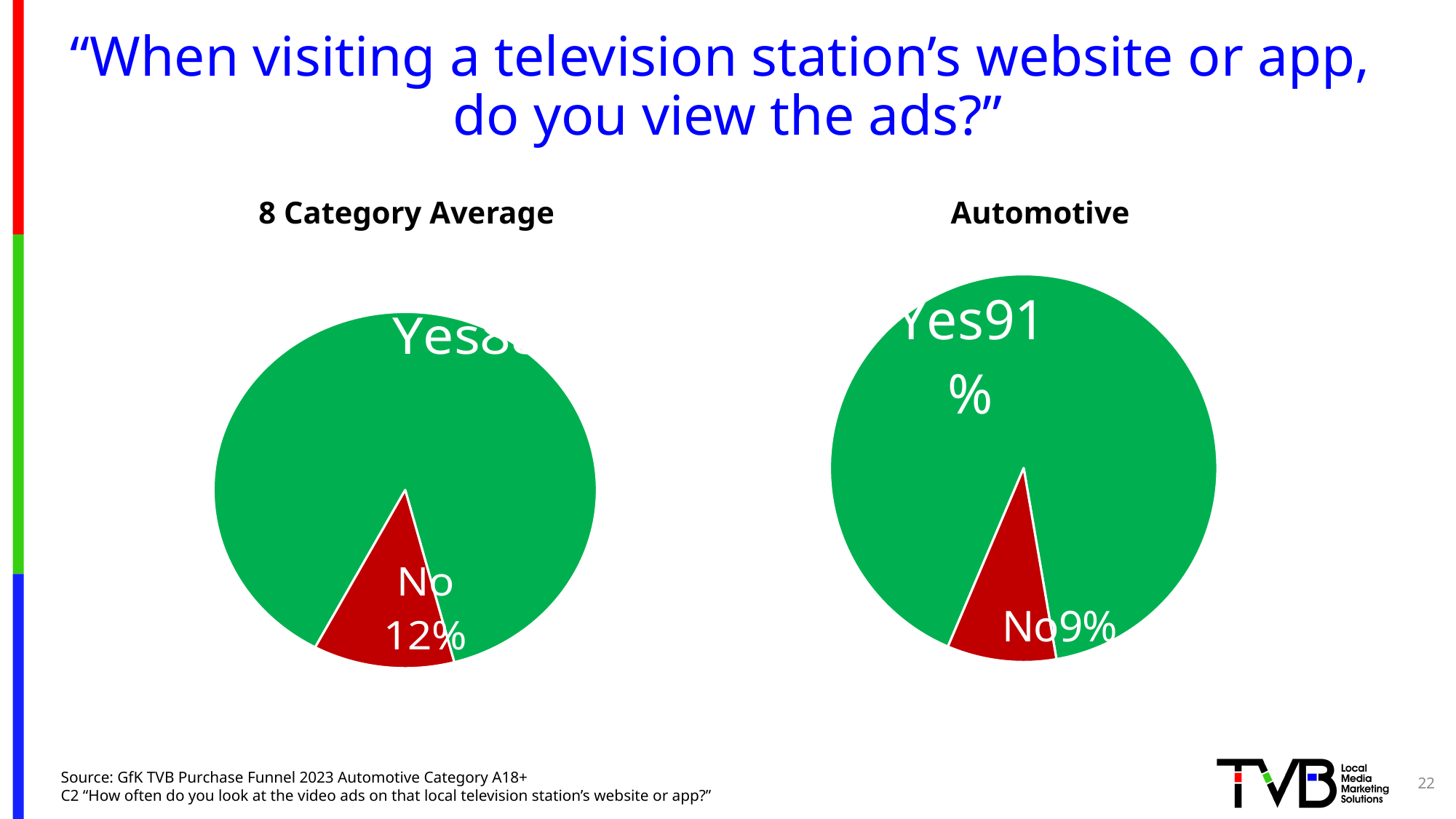
In the 8 Category Average pie chart, what percentage answered No? 12% In the 8 Category Average pie chart, which response has the smallest share? No How many slices does the Automotive pie chart have? 2 In the Automotive pie chart, which response has the largest share? Yes In the Automotive pie chart, what percentage answered No? 9% What is the title of the pie chart on the right side of the slide? Automotive What kind of chart is used for the 8 Category Average data? Pie chart In the Automotive pie chart, what percentage answered Yes? 91% Which pie chart shows a larger No share, 8 Category Average or Automotive? 8 Category Average What colour is the No slice in both pie charts? Red In the Automotive pie chart, what is the difference in percentage points between Yes and No? 82 In the Automotive pie chart, is the Yes share greater or less than 50%? greater